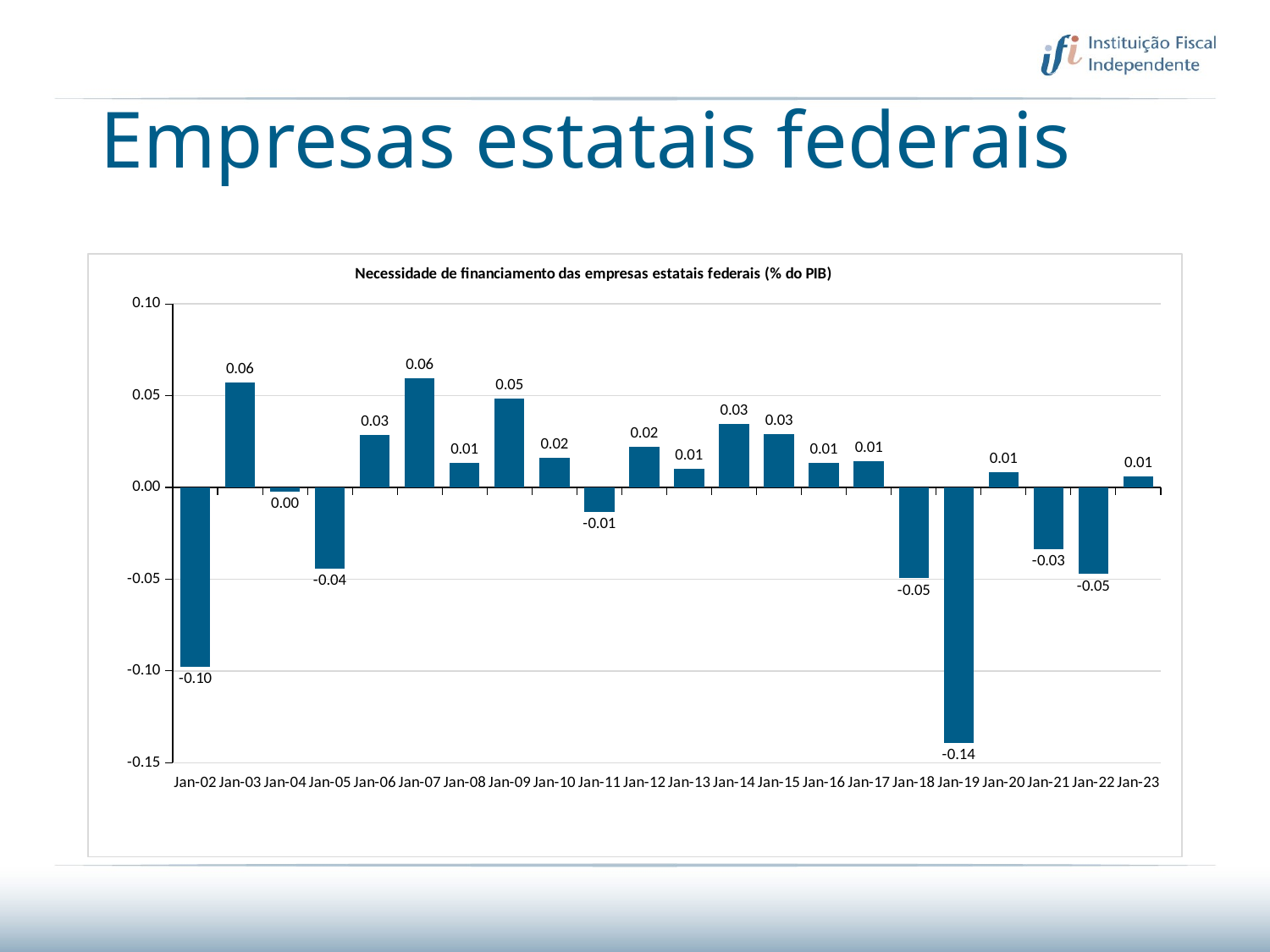
What is the value for Jan-02? -0.10 What is the value for Jan-22? -0.05 What kind of chart is shown on the slide? bar chart Which year has the lowest value? Jan-19 What is the difference between the values for Jan-09 and Jan-08? 0.04 What is the value for Jan-09? 0.05 What is the title of the chart? Necessidade de financiamento das empresas estatais federais (% do PIB) What is the difference between the values for Jan-02 and Jan-19? 0.04 How many years are shown on the x axis? 22 Is the value for Jan-02 greater or less than -0.05? less What is the value for Jan-19? -0.14 Which is larger, the value for Jan-09 or the value for Jan-06? Jan-09